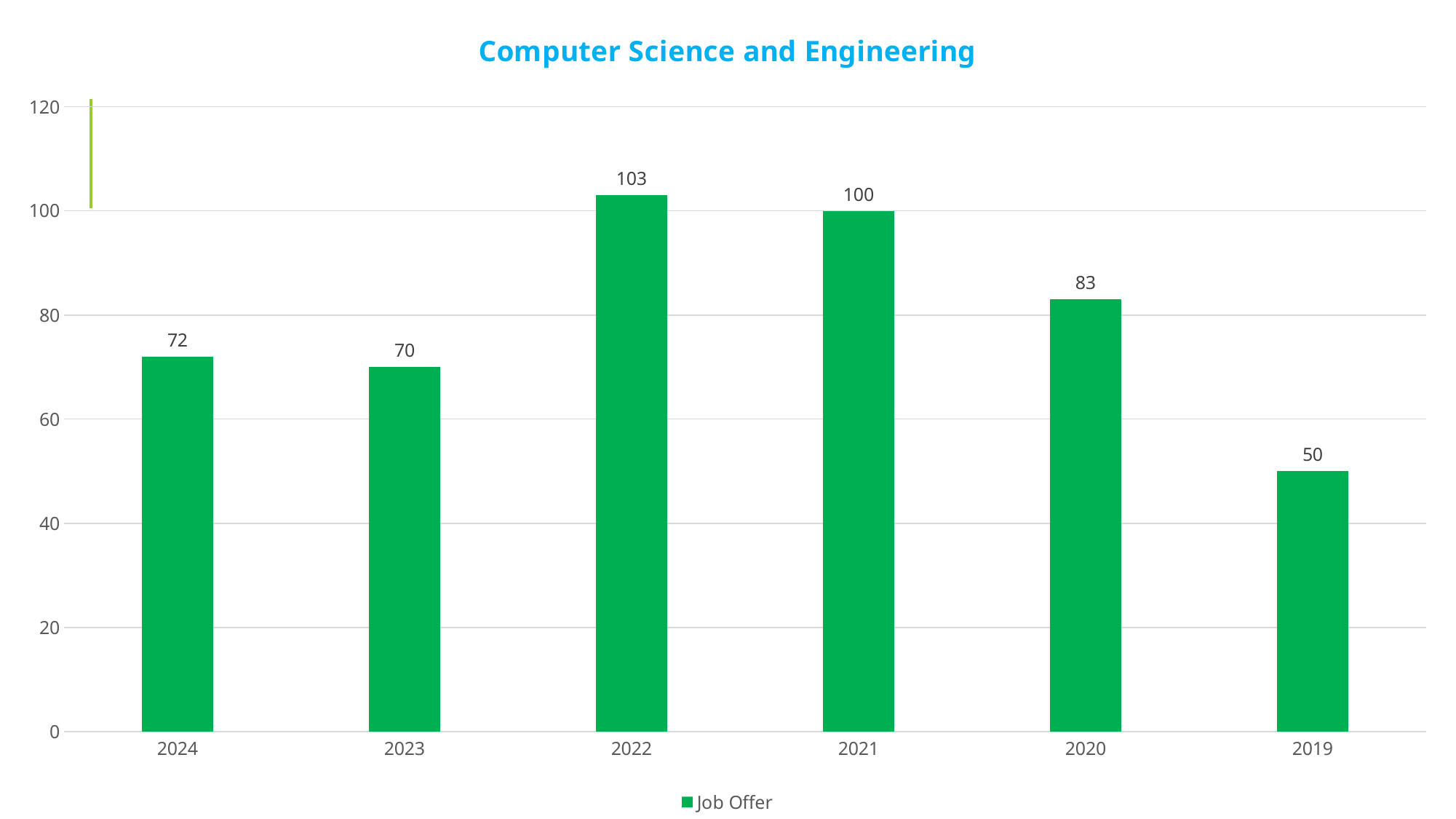
What is the difference between the Job Offer values for 2021 and 2020? 17 Which year has the highest Job Offer value? 2022 Which year has the lowest Job Offer value? 2019 What is the Job Offer value for 2022? 103 Which year has a larger Job Offer value, 2023 or 2020? 2020 What is the title of the chart? Computer Science and Engineering What is the Job Offer value for 2024? 72 What kind of chart is shown on the slide? Bar chart How many years are shown on the x axis? 6 Is the Job Offer value for 2020 greater or less than 80? greater How many series does the legend list? 1 What is the Job Offer value for 2019? 50